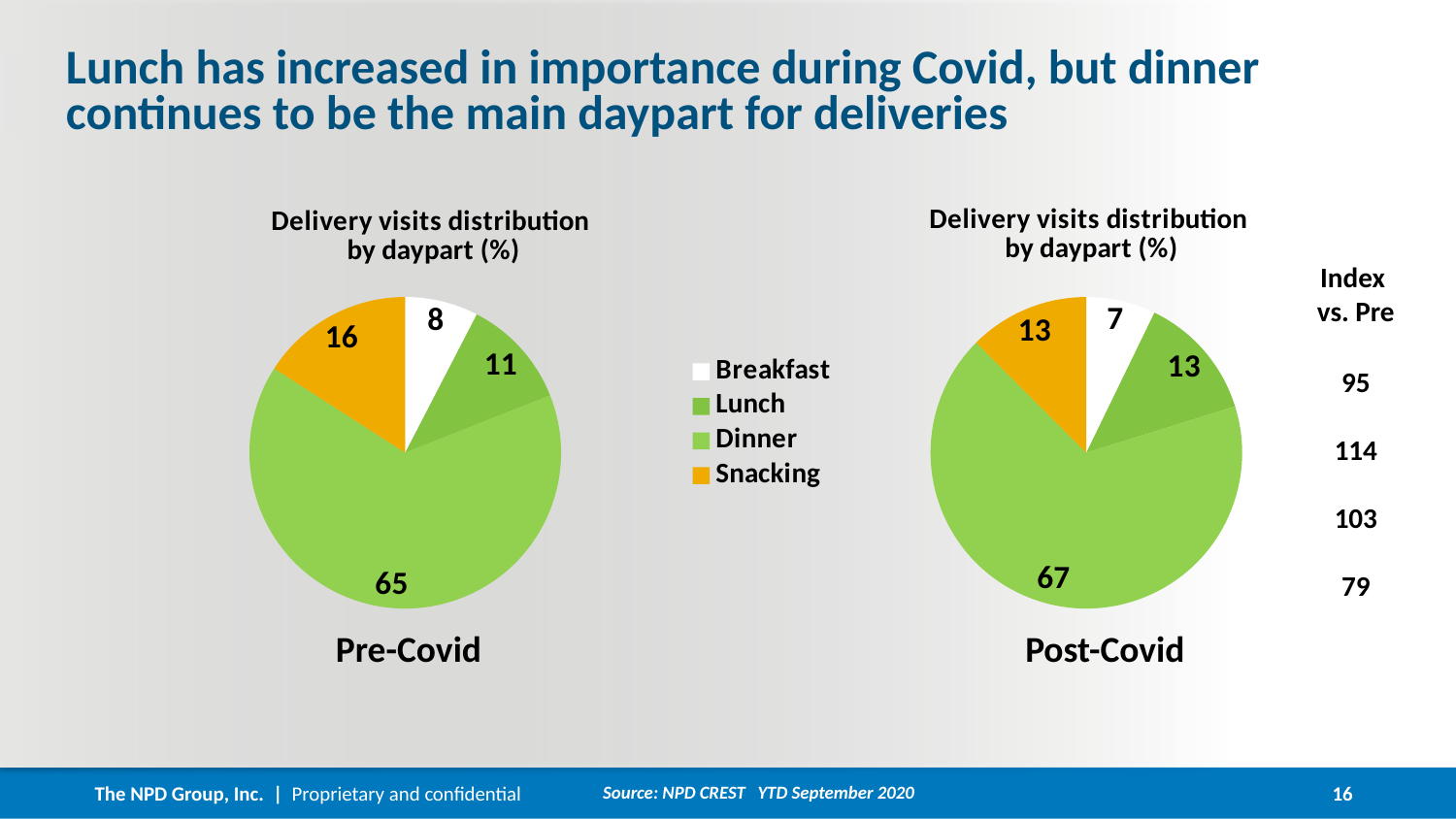
What type of chart is used to show the Post-Covid delivery visits distribution? Pie chart In the Post-Covid pie chart, which daypart has the smallest share? Breakfast What is the difference between the Dinner value in the Post-Covid pie chart and the Dinner value in the Pre-Covid pie chart? 2 Is the Lunch value larger in the Pre-Covid pie chart or the Post-Covid pie chart? Post-Covid In the Pre-Covid pie chart, what is the value for Snacking? 16 In the Post-Covid pie chart, what is the value for Breakfast? 7 In the Post-Covid pie chart, what is the value for Lunch? 13 How many entries does the legend list? 4 In the Pre-Covid pie chart, which daypart has the largest share? Dinner How many slices does the Pre-Covid pie chart have? 4 In the Pre-Covid pie chart, which daypart has the smallest share? Breakfast In the Pre-Covid pie chart, what is the value for Dinner? 65